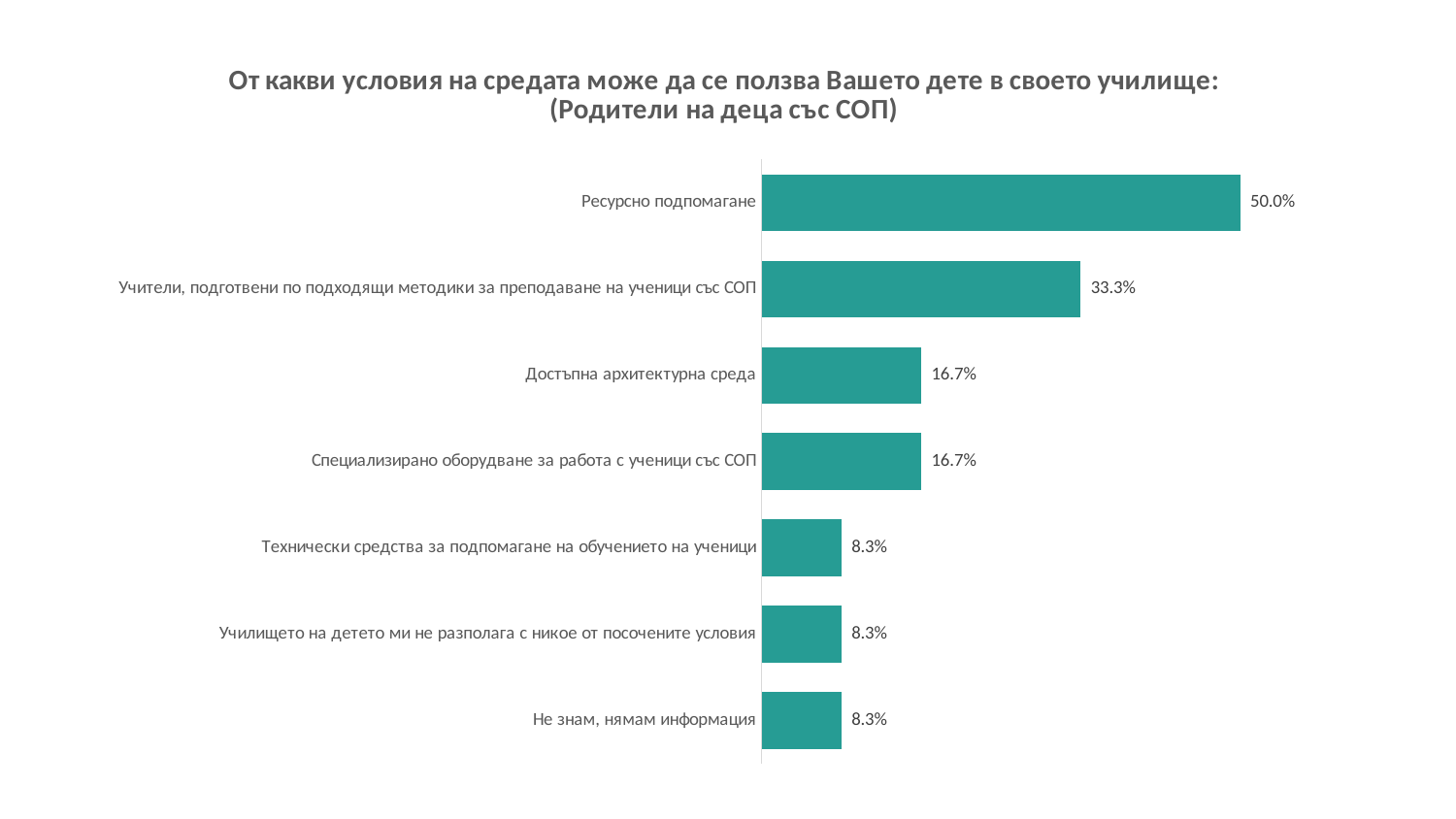
What kind of chart is shown on the slide? Bar chart What is the value for "Ресурсно подпомагане"? 50.0% What is the title of the chart? От какви условия на средата може да се ползва Вашето дете в своето училище: (Родители на деца със СОП) Which is larger: the value for "Специализирано оборудване за работа с ученици със СОП" or the value for "Училището на детето ми не разполага с никое от посочените условия"? Специализирано оборудване за работа с ученици със СОП What is the value for "Не знам, нямам информация"? 8.3% What is the difference between the values for "Ресурсно подпомагане" and "Учители, подготвени по подходящи методики за преподаване на ученици със СОП"? 16.7% How many categories are shown in the chart? 7 What is the value for "Учители, подготвени по подходящи методики за преподаване на ученици със СОП"? 33.3% What is the difference between the values for "Достъпна архитектурна среда" and "Технически средства за подпомагане на обучението на ученици"? 8.4% Which category has the highest value? Ресурсно подпомагане What is the value for "Достъпна архитектурна среда"? 16.7% How many categories have a value of 8.3%? 3